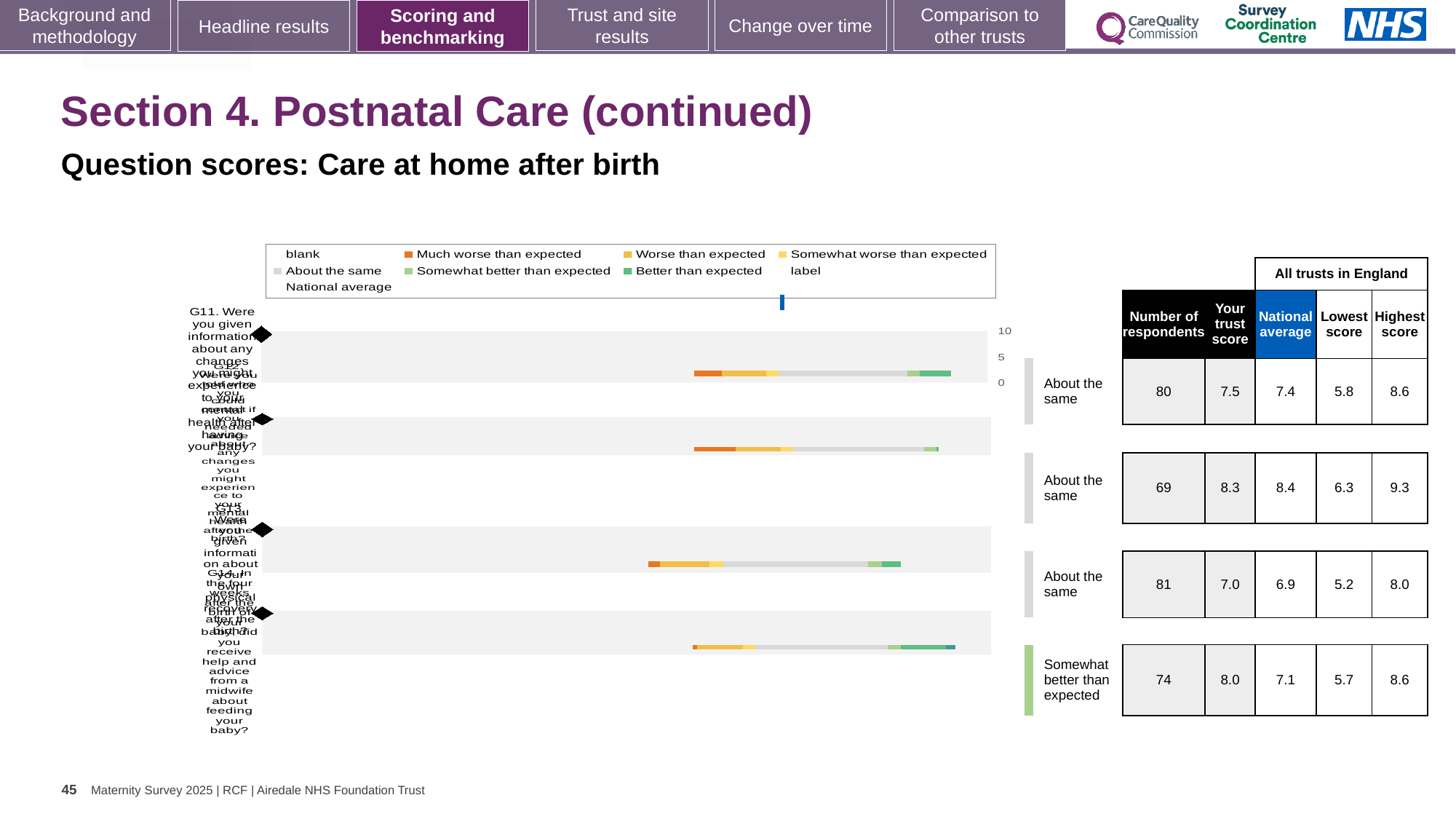
What kind of chart is shown on the slide? bar chart For the top (first) row, which is larger: 'Your trust score' or the National average? Your trust score In the table beside the chart, what is the 'Your trust score' for the top (first) row? 7.5 How many question rows (bars) are plotted in the chart? 4 In the table beside the chart, what is the Number of respondents for the third row? 81 For the bottom (fourth) row, what is the difference between 'Your trust score' and the National average? 0.9 What colour does the legend use for 'Much worse than expected'? orange Which row has the highest 'Your trust score' in the table beside the chart? the second row (8.3) What is the smallest 'Lowest score' value shown in the table beside the chart? 5.2 In the table beside the chart, what is the National average for the second row? 8.4 In the table beside the chart, what is the Highest score for the bottom (fourth) row? 8.6 Which row is rated 'Somewhat better than expected' rather than 'About the same'? the bottom (fourth) row